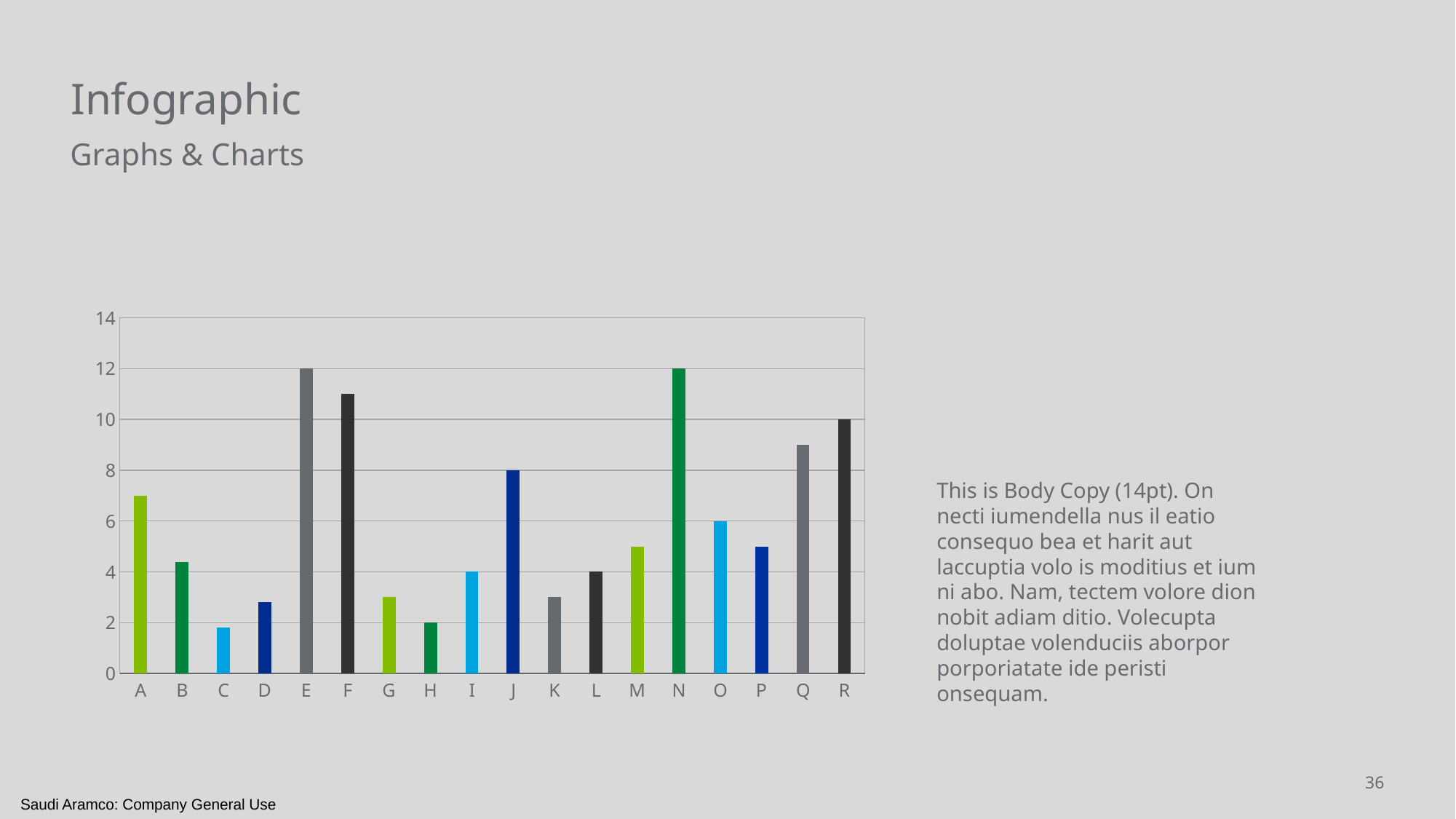
What is the value for category O? 6 What is the difference between the values for E and J? 4 Which is larger, the value for R or the value for J? R What is the value for category H? 2 What kind of chart is shown on the slide? bar chart What is the value for category R? 10 How many categories are shown on the x axis of the chart? 18 What is the difference between the values for N and H? 10 Is the value for D greater or less than 4? less Is the value for F greater or less than 10? greater What is the value for category J? 8 What is the value for category E? 12